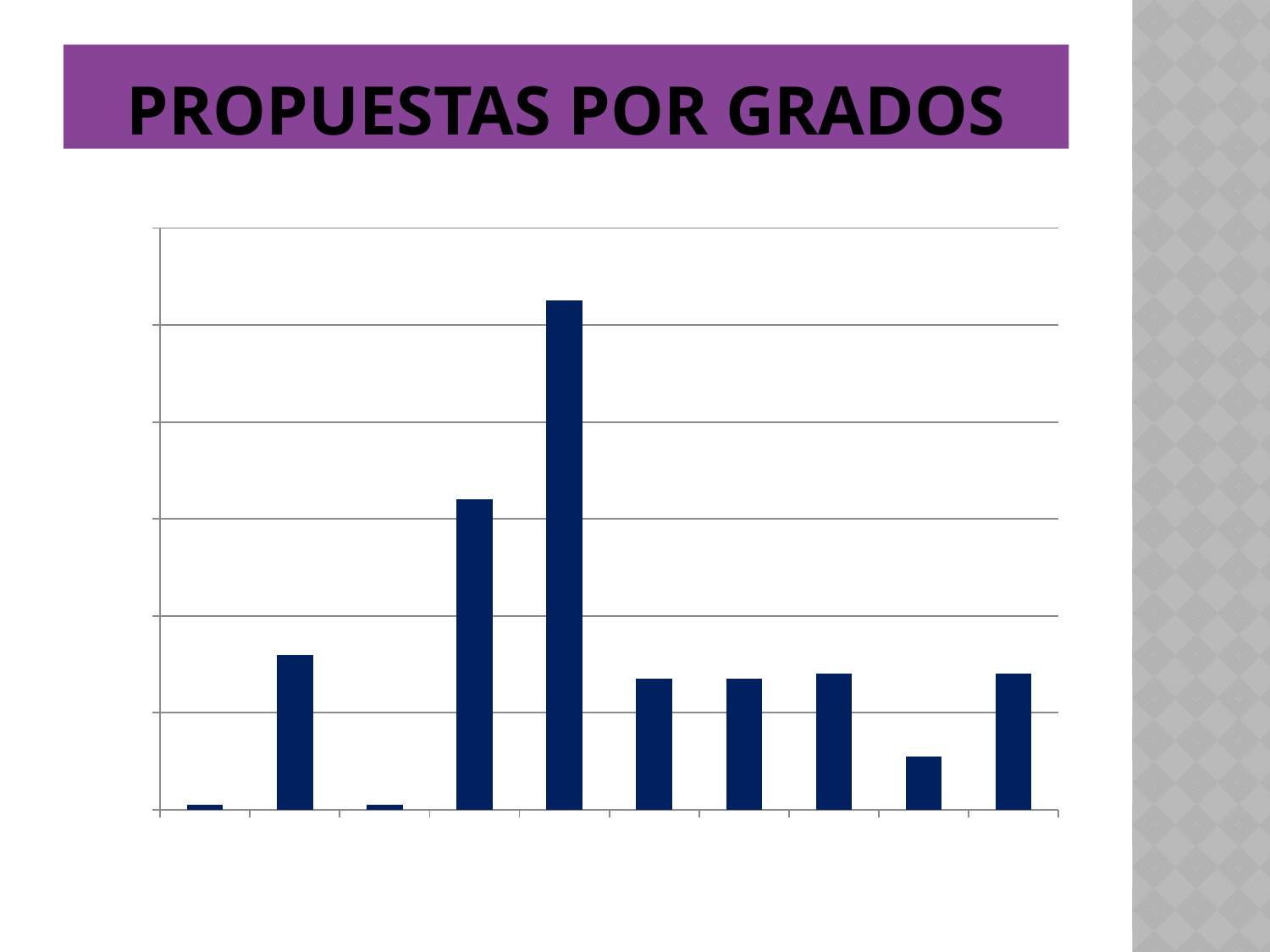
What is the title shown above the chart on the slide? PROPUESTAS POR GRADOS Which is taller, the ninth bar from the left or the tenth bar from the left? the tenth bar Which is taller, the seventh bar from the left or the ninth bar from the left? the seventh bar Which is taller, the fourth bar from the left or the fifth bar from the left? the fifth bar How many bars are plotted in the chart? 10 What colour are the bars in the chart? dark blue Which bar is the tallest in the chart? the fifth bar from the left What kind of chart is shown on the slide? bar chart